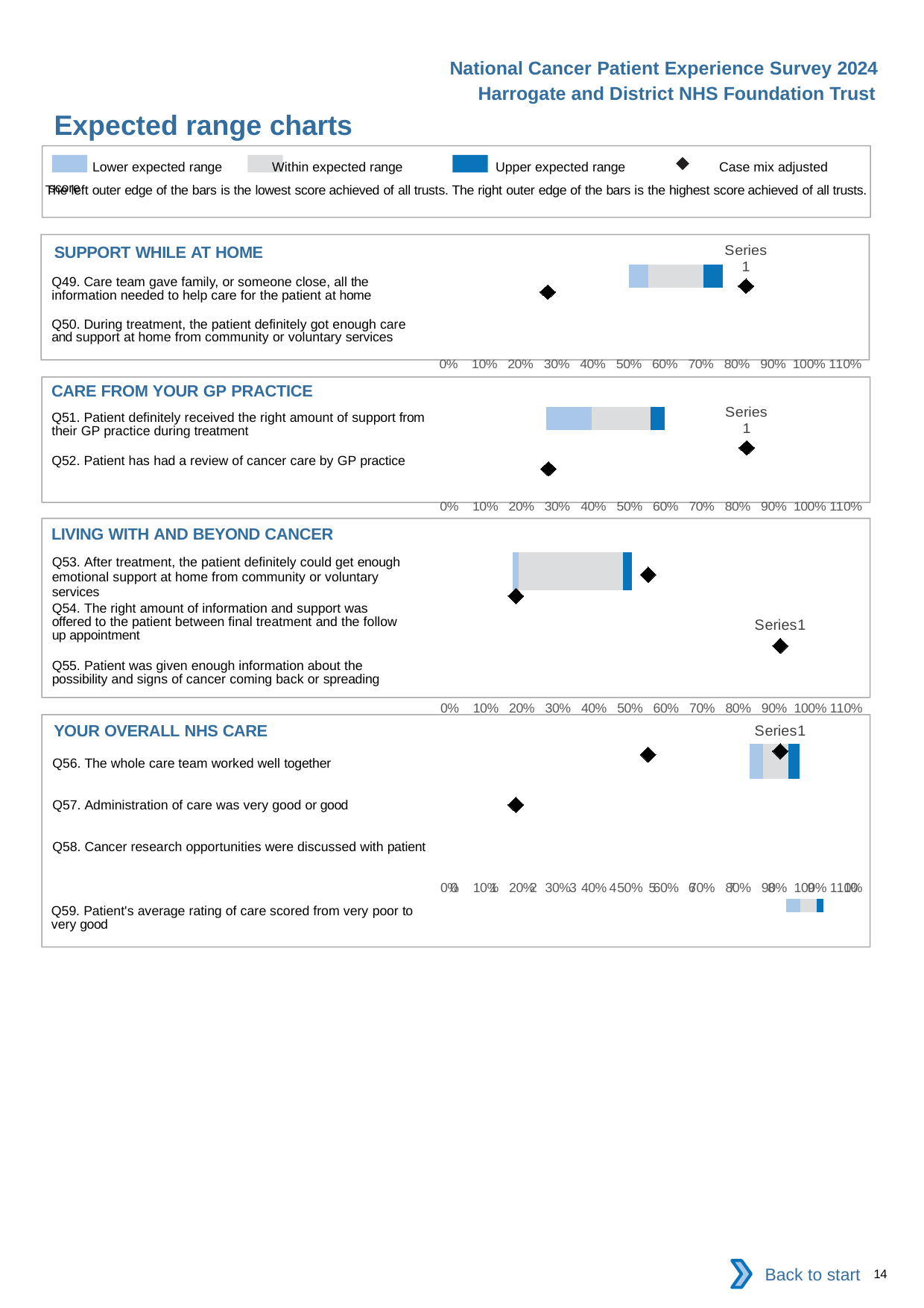
In the YOUR OVERALL NHS CARE chart, is the diamond marker on the Q57 row greater or less than 40%? less What kind of chart is used in the SUPPORT WHILE AT HOME section? Bar chart What is the title of the slide? Expected range charts In the YOUR OVERALL NHS CARE chart, is the right edge of the expected range bar on the Q56 row greater or less than 80%? greater How many entries does the legend at the top of the slide list? 4 According to the legend, what does the black diamond marker represent? Case mix adjusted score How many questions are listed in the YOUR OVERALL NHS CARE chart? 4 How many questions are listed in the LIVING WITH AND BEYOND CANCER chart? 3 How many questions are listed in the SUPPORT WHILE AT HOME chart? 2 What is the highest percentage tick shown on the x axis of the CARE FROM YOUR GP PRACTICE chart? 110%